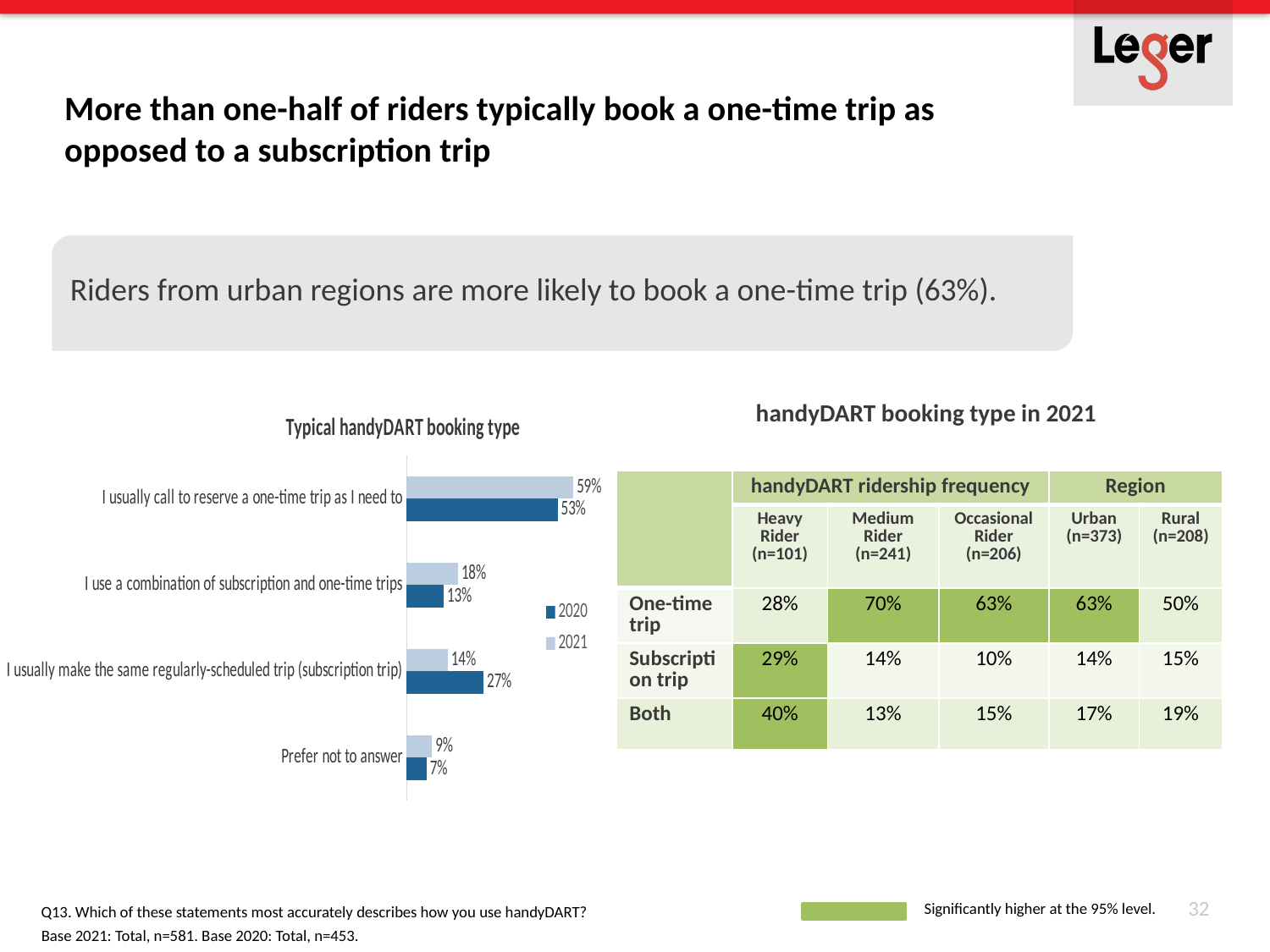
In the 'Typical handyDART booking type' chart, what is the 2020 value for 'Prefer not to answer'? 7% What type of chart is 'Typical handyDART booking type'? bar chart In the 'Typical handyDART booking type' chart, what is the 2021 value for 'I usually call to reserve a one-time trip as I need to'? 59% In the 'Typical handyDART booking type' chart, what is the 2020 value for 'I usually call to reserve a one-time trip as I need to'? 53% In the 'Typical handyDART booking type' chart, which category has the highest 2021 value? I usually call to reserve a one-time trip as I need to How many categories are shown in the 'Typical handyDART booking type' chart? 4 In the 'Typical handyDART booking type' chart, what is the 2020 value for 'I usually make the same regularly-scheduled trip (subscription trip)'? 27% In the 'Typical handyDART booking type' chart, is the 2021 value for 'I use a combination of subscription and one-time trips' larger or smaller than the 2020 value? larger In the 'Typical handyDART booking type' chart, which category has the lowest 2020 value? Prefer not to answer In the 'Typical handyDART booking type' chart, what is the 2021 value for 'I use a combination of subscription and one-time trips'? 18% In the 'Typical handyDART booking type' chart, what is the difference between the 2020 and 2021 values for 'I usually make the same regularly-scheduled trip (subscription trip)'? 13% How many series does the legend of the 'Typical handyDART booking type' chart list? 2